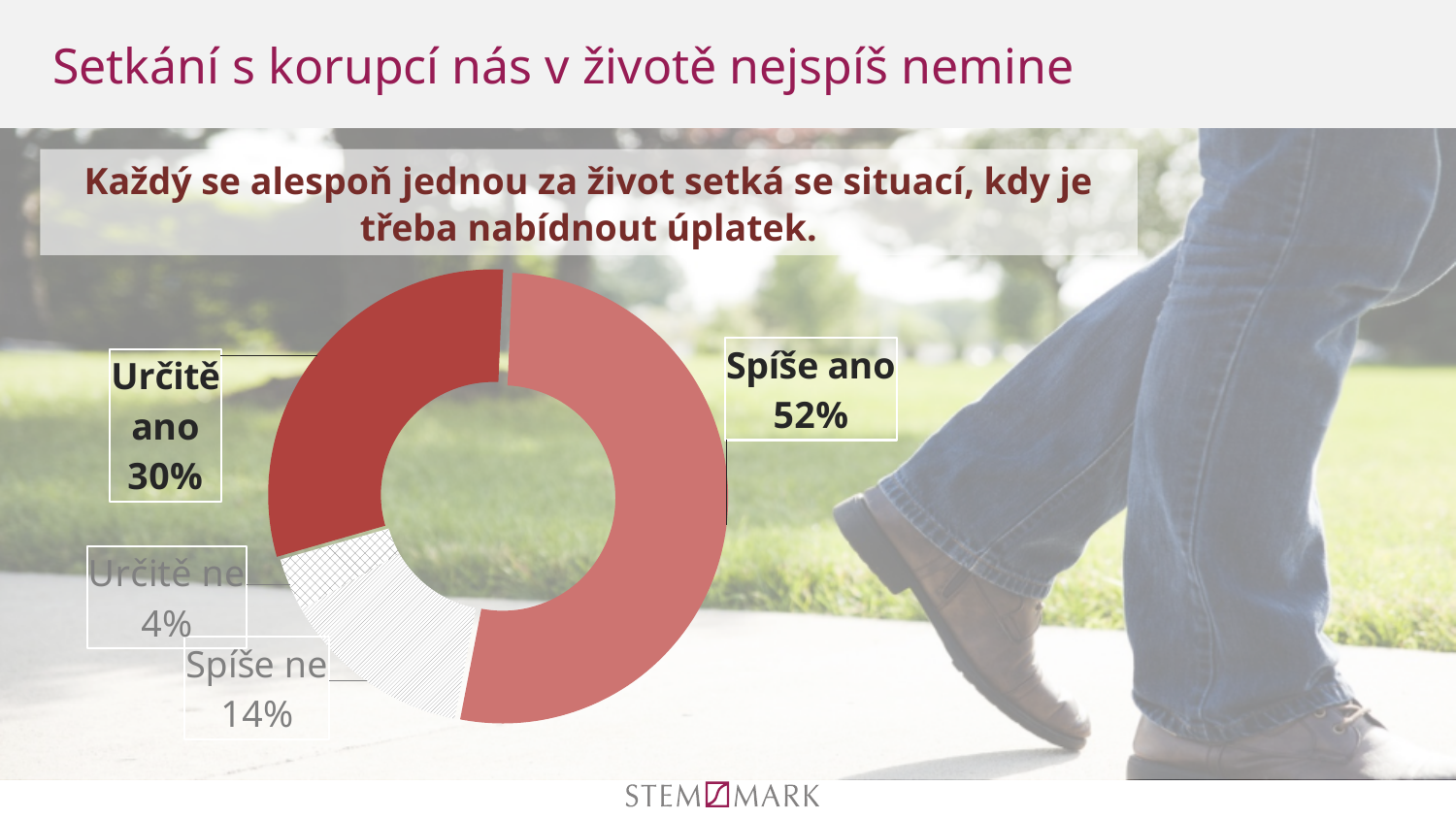
How many answer categories are shown in the chart? 4 What percentage of respondents answered "Určitě ano"? 30% What percentage of respondents answered "Spíše ano"? 52% What is the combined share of "Určitě ano" and "Spíše ano"? 82% What percentage of respondents answered "Spíše ne"? 14% What is the difference in percentage points between "Spíše ano" and "Určitě ano"? 22 What percentage of respondents answered "Určitě ne"? 4% What is the title of the slide? Setkání s korupcí nás v životě nejspíš nemine Which answer category has the largest share of the chart? Spíše ano Which answer category has the smallest share of the chart? Určitě ne What kind of chart is shown on the slide? Pie chart (donut) Which is larger, the share for "Spíše ne" or the share for "Určitě ne"? Spíše ne